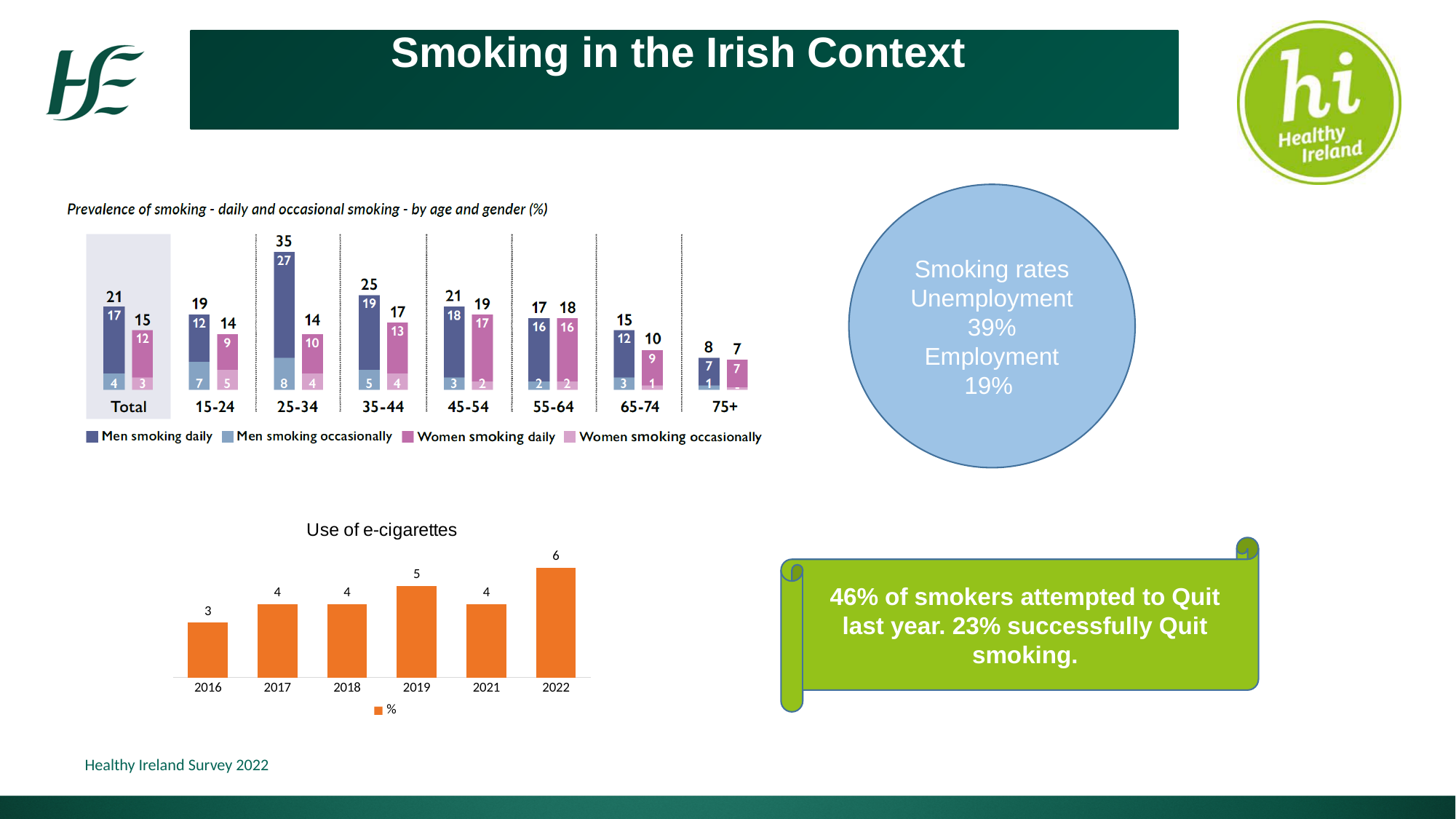
In the 'Use of e-cigarettes' chart, what is the difference between the values for 2022 and 2016? 3 In the 'Prevalence of smoking' chart, what is the value for women smoking daily in the 45-54 age group? 17 In the 'Use of e-cigarettes' chart, which year has the lowest value? 2016 In the 'Use of e-cigarettes' chart, which year has the highest value? 2022 In the 'Prevalence of smoking' chart, what is the total value for men in the 25-34 age group? 35 What kind of chart is the 'Use of e-cigarettes' chart? Bar chart In the 'Prevalence of smoking' chart, how many series does the legend list? 4 In the 'Use of e-cigarettes' chart, what is the value for 2022? 6 In the 'Prevalence of smoking' chart, is the total for men in the 55-64 age group larger or smaller than the total for women in that group? Smaller In the 'Prevalence of smoking' chart, which age group has the highest total for men? 25-34 In the 'Use of e-cigarettes' chart, what is the value for 2016? 3 In the 'Use of e-cigarettes' chart, how many years are shown on the x axis? 6